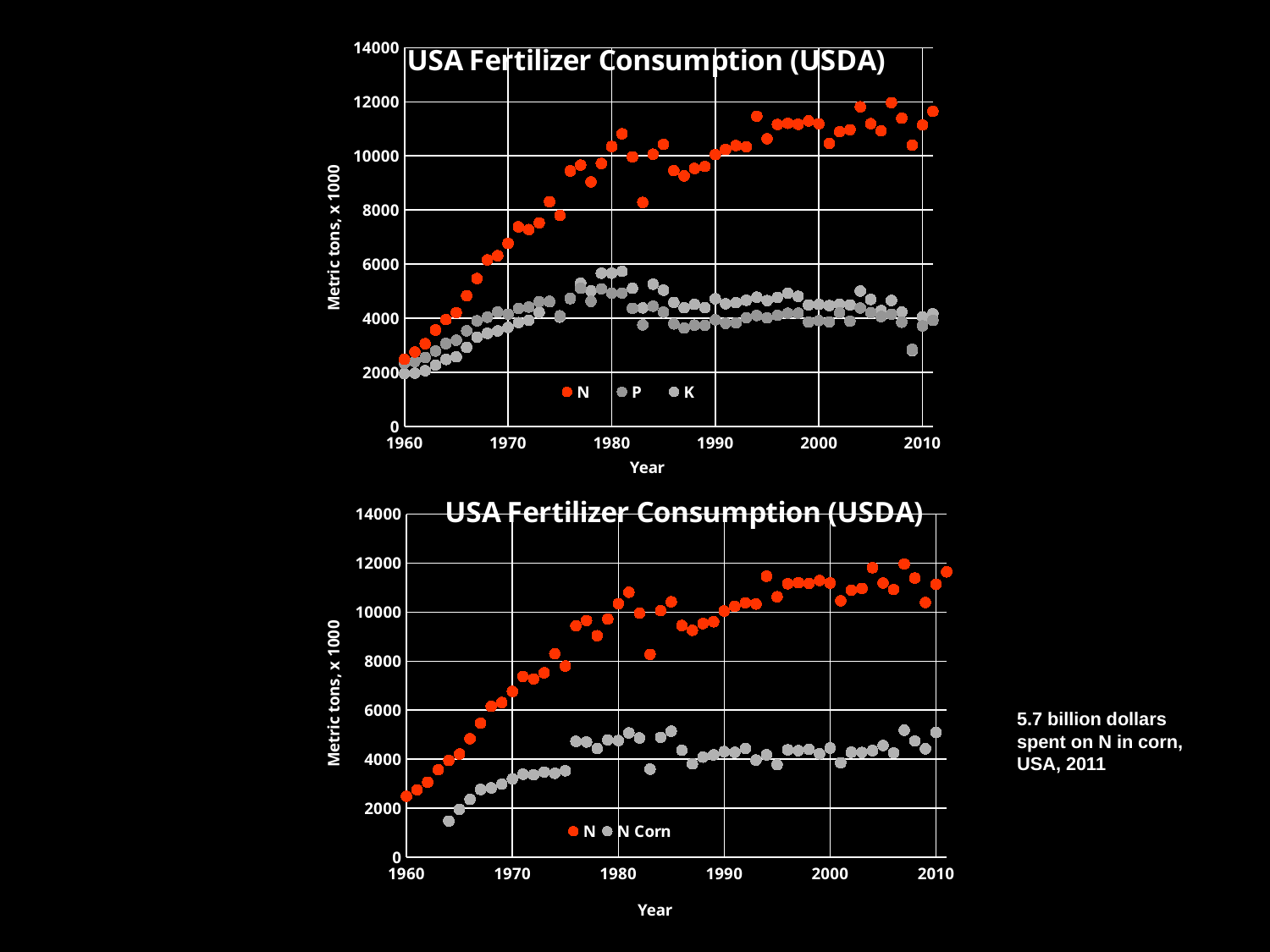
In the top chart, is the value for N in 1960 greater or less than 4000? less What is the y-axis label of the bottom chart? Metric tons, x 1000 In the top chart, which series has the larger value in 2000, N or P? N In the top chart, does the N series generally rise or fall from 1960 to 2010? Rise In the top chart, is the value for N in 2010 greater or less than 10000? greater What type of chart is the top chart on the slide? Scatter chart In the bottom chart, is the value for N Corn in 1965 greater or less than 4000? less How many series does the legend of the top chart list? 3 How many series does the legend of the bottom chart list? 2 What are the series names in the legend of the top chart? N, P, K In the bottom chart, which series has the larger value in 1990, N or N Corn? N